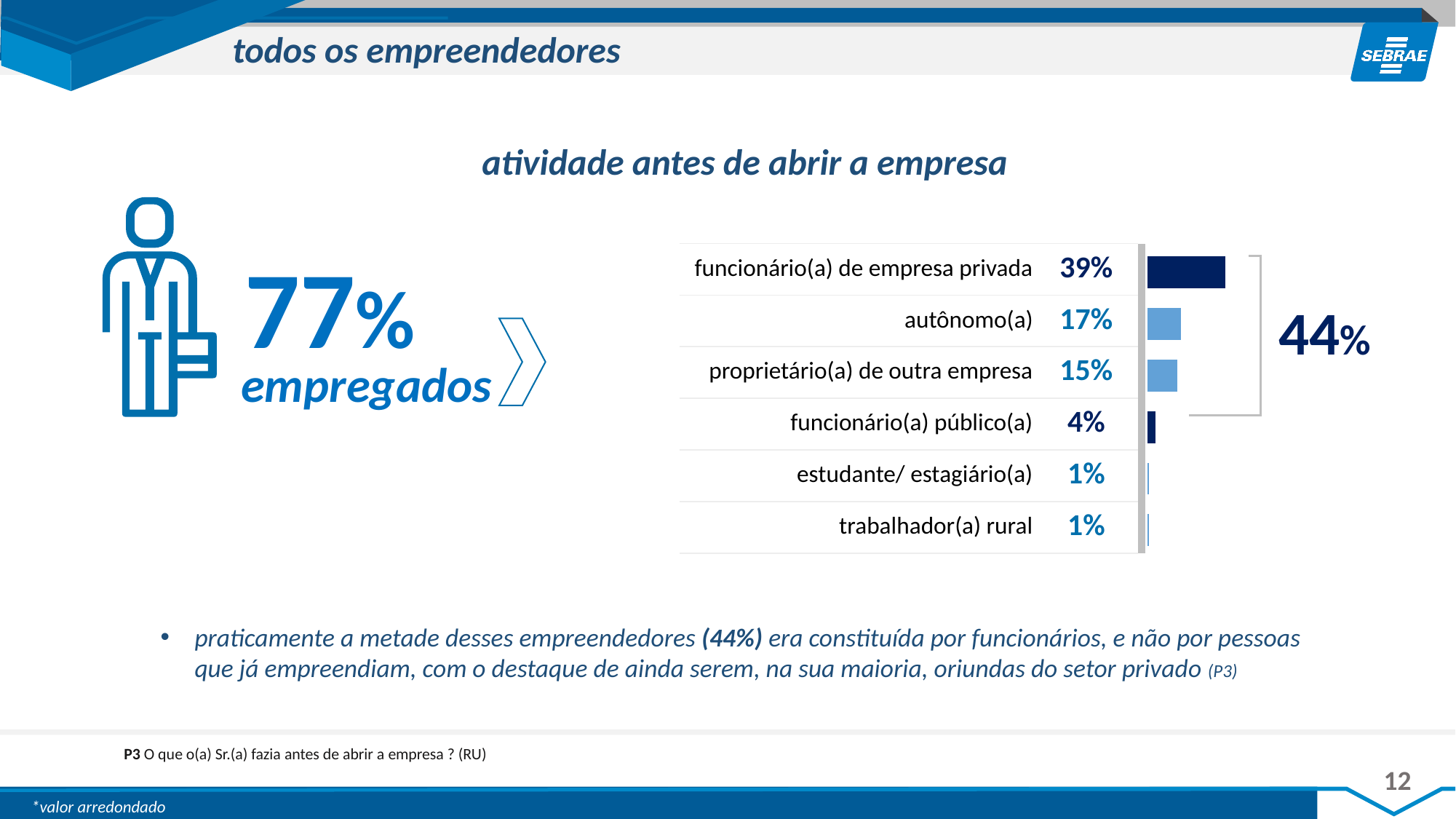
What percentage is shown next to the bracket grouping the bars on the right of the chart? 44% Which is larger: the value for autônomo(a) or for proprietário(a) de outra empresa? autônomo(a) What is the title of the chart? atividade antes de abrir a empresa What is the difference in percentage points between funcionário(a) de empresa privada and autônomo(a)? 22 percentage points What percentage is shown for proprietário(a) de outra empresa? 15% What percentage is shown for estudante/ estagiário(a)? 1% What kind of chart is used to show the activity before opening the company? bar chart What value is shown for autônomo(a) in the chart? 17% How many categories does the chart show? 6 Which category has the highest value in the chart? funcionário(a) de empresa privada What percentage of entrepreneurs were funcionário(a) de empresa privada before opening their company? 39% What value does the chart show for funcionário(a) público(a)? 4%